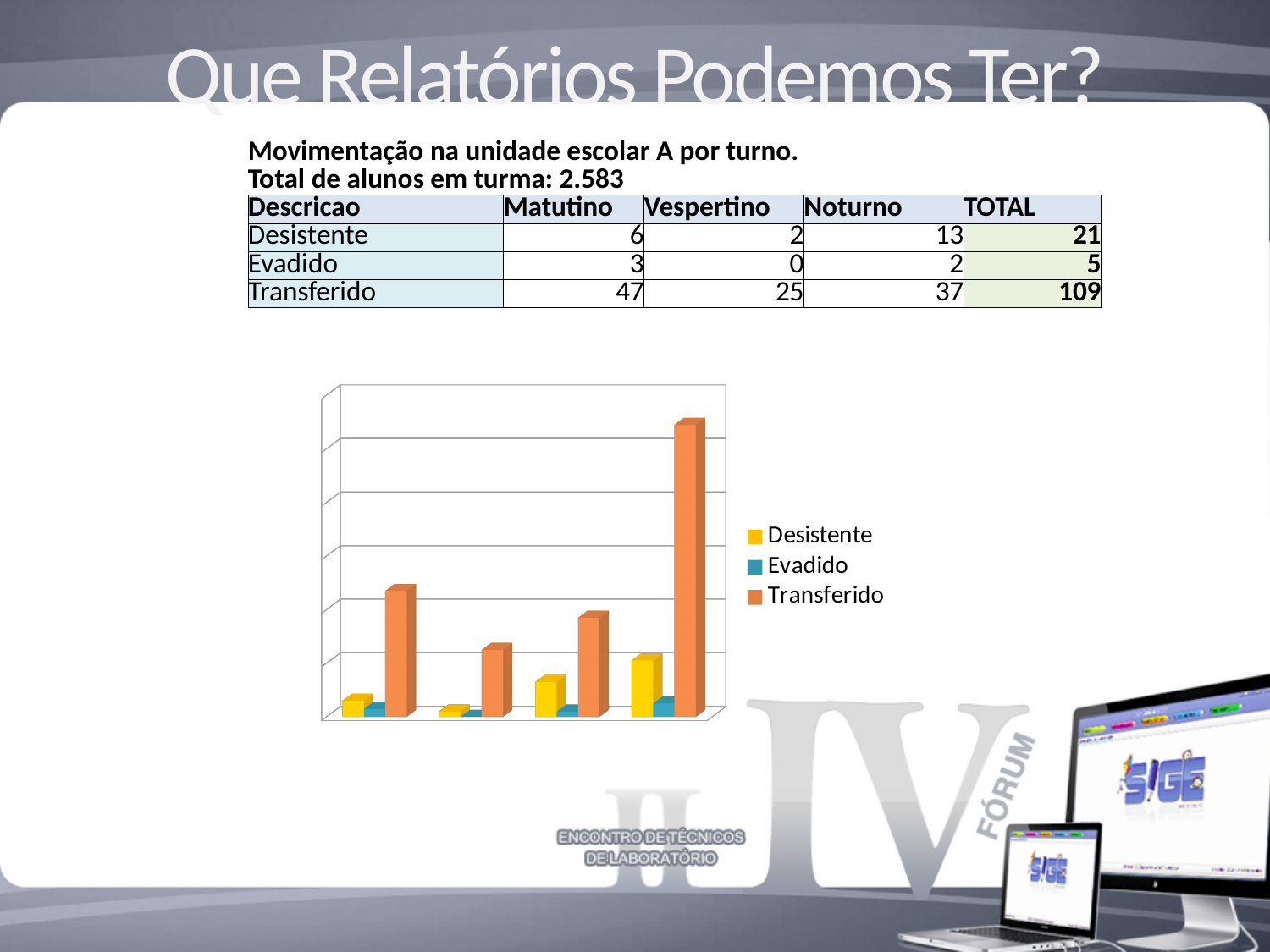
How many groups of bars are plotted in the chart? 4 Which series has the shortest bars in the chart? Evadido According to the table above the chart, what is the difference between the TOTAL for Transferido and the TOTAL for Desistente? 88 What kind of chart is shown on the slide? bar chart Which series has the tallest bar in the chart? Transferido What are the series names listed in the chart's legend? Desistente, Evadido, Transferido According to the table above the chart, what is the TOTAL for Transferido? 109 In the chart, which series is drawn in orange? Transferido How many series does the chart's legend list? 3 In the rightmost group of bars, is the Transferido bar taller or shorter than the Desistente bar? taller According to the table above the chart, what is the Noturno value for Desistente? 13 According to the table above the chart, which description has the lowest TOTAL? Evadido